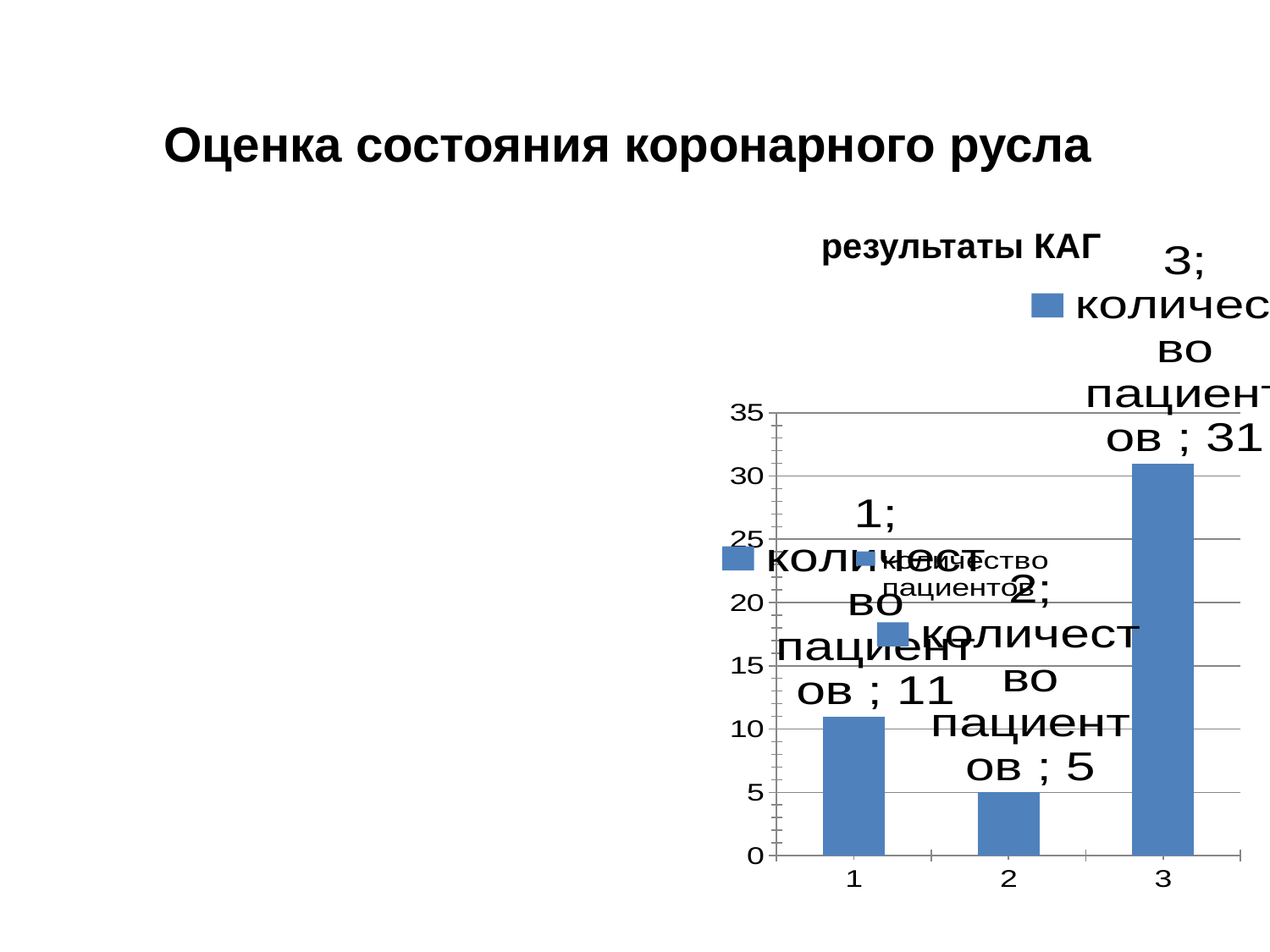
Which is larger, the value for category 1 or the value for category 2? category 1 What is the value for category 3? 31 What is the title of the chart? результаты КАГ Is the value for category 3 greater or less than 30? greater Which category has the lowest value? 2 What is the difference between the values for category 3 and category 1? 20 What is the value for category 1? 11 What is the difference between the values for category 1 and category 2? 6 What kind of chart is shown on the slide? bar chart What is the value for category 2? 5 How many categories are shown on the x axis? 3 Which category has the highest value? 3